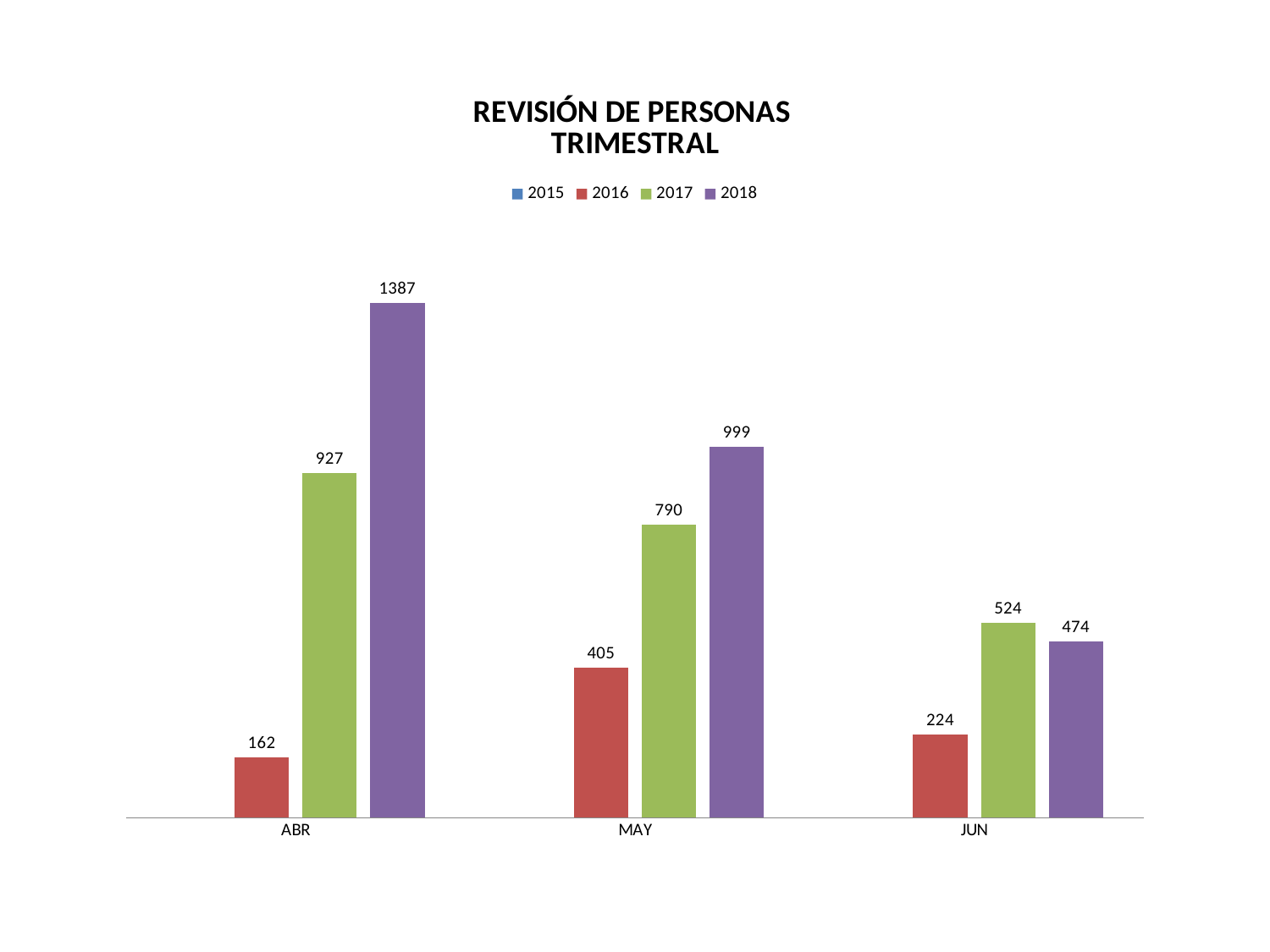
What is the value for 2018 in ABR? 1387 Which is larger in JUN, the 2017 value or the 2018 value? 2017 What is the value for 2016 in MAY? 405 Which month has the highest value for 2018? ABR How many series does the legend list? 4 What kind of chart is this? Bar chart How many months are shown on the x axis? 3 What is the value for 2017 in JUN? 524 What is the difference between the 2018 and 2017 values in MAY? 209 Do the 2017 values rise or fall from ABR to JUN? Fall Which month has the lowest value for 2016? ABR What is the title of the chart? REVISIÓN DE PERSONAS TRIMESTRAL